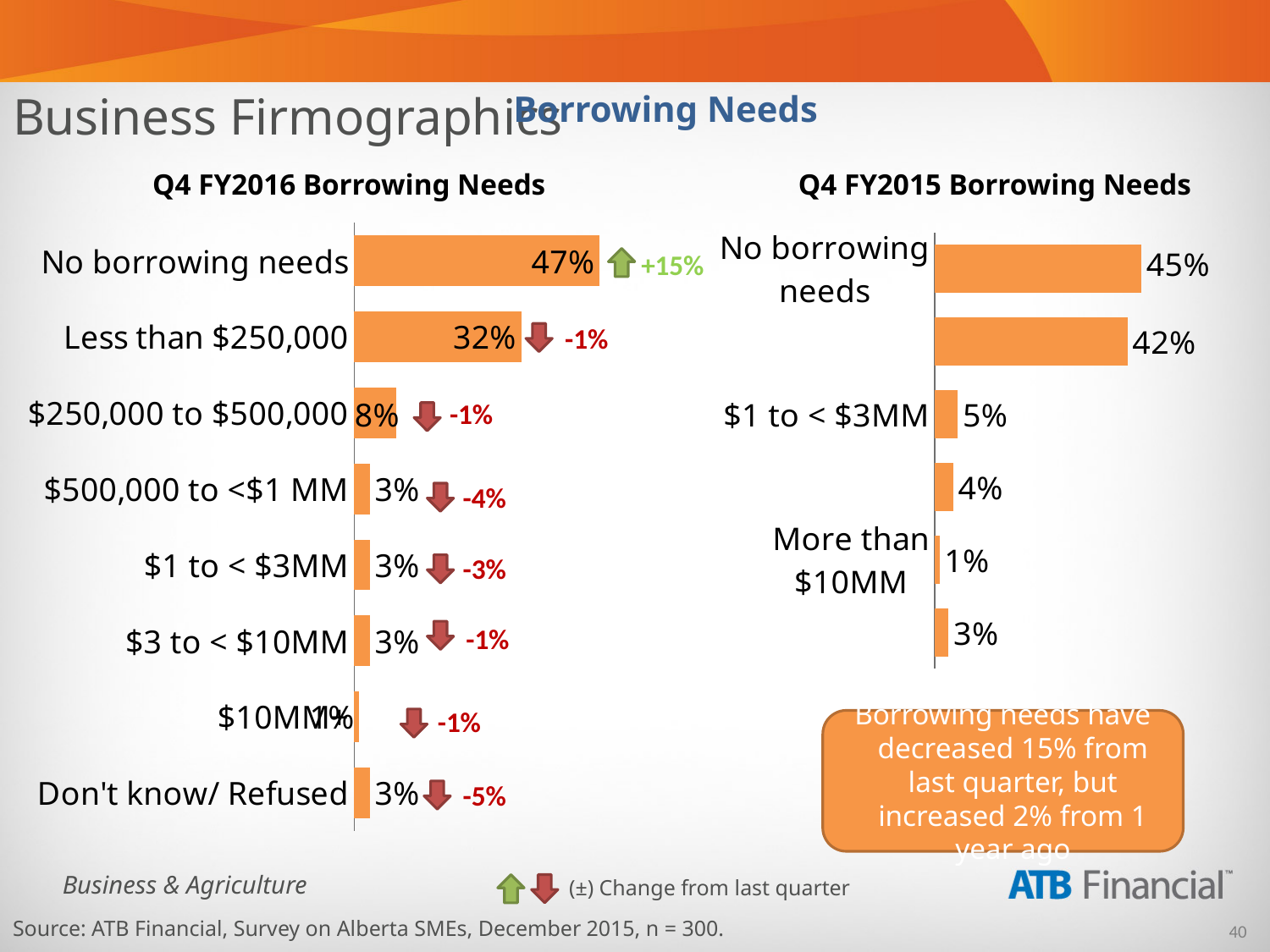
In the Q4 FY2015 Borrowing Needs chart, what is the value for No borrowing needs? 45% In the Q4 FY2016 Borrowing Needs chart, what is the change from last quarter shown next to No borrowing needs? +15% In the Q4 FY2016 Borrowing Needs chart, what is the value for Less than $250,000? 32% What type of chart is the Q4 FY2015 Borrowing Needs chart? Bar chart In the Q4 FY2016 Borrowing Needs chart, which category has the highest value? No borrowing needs In the Q4 FY2015 Borrowing Needs chart, what is the value for More than $10MM? 1% Which is larger: No borrowing needs in the Q4 FY2016 chart or No borrowing needs in the Q4 FY2015 chart? Q4 FY2016 (47%) In the Q4 FY2016 Borrowing Needs chart, what is the difference between No borrowing needs and Less than $250,000? 15% In the Q4 FY2016 Borrowing Needs chart, what is the value for No borrowing needs? 47% In the Q4 FY2015 Borrowing Needs chart, what is the value for $1 to < $3MM? 5% In the Q4 FY2016 Borrowing Needs chart, how many categories are shown? 8 In the Q4 FY2016 Borrowing Needs chart, what is the value for $250,000 to $500,000? 8%